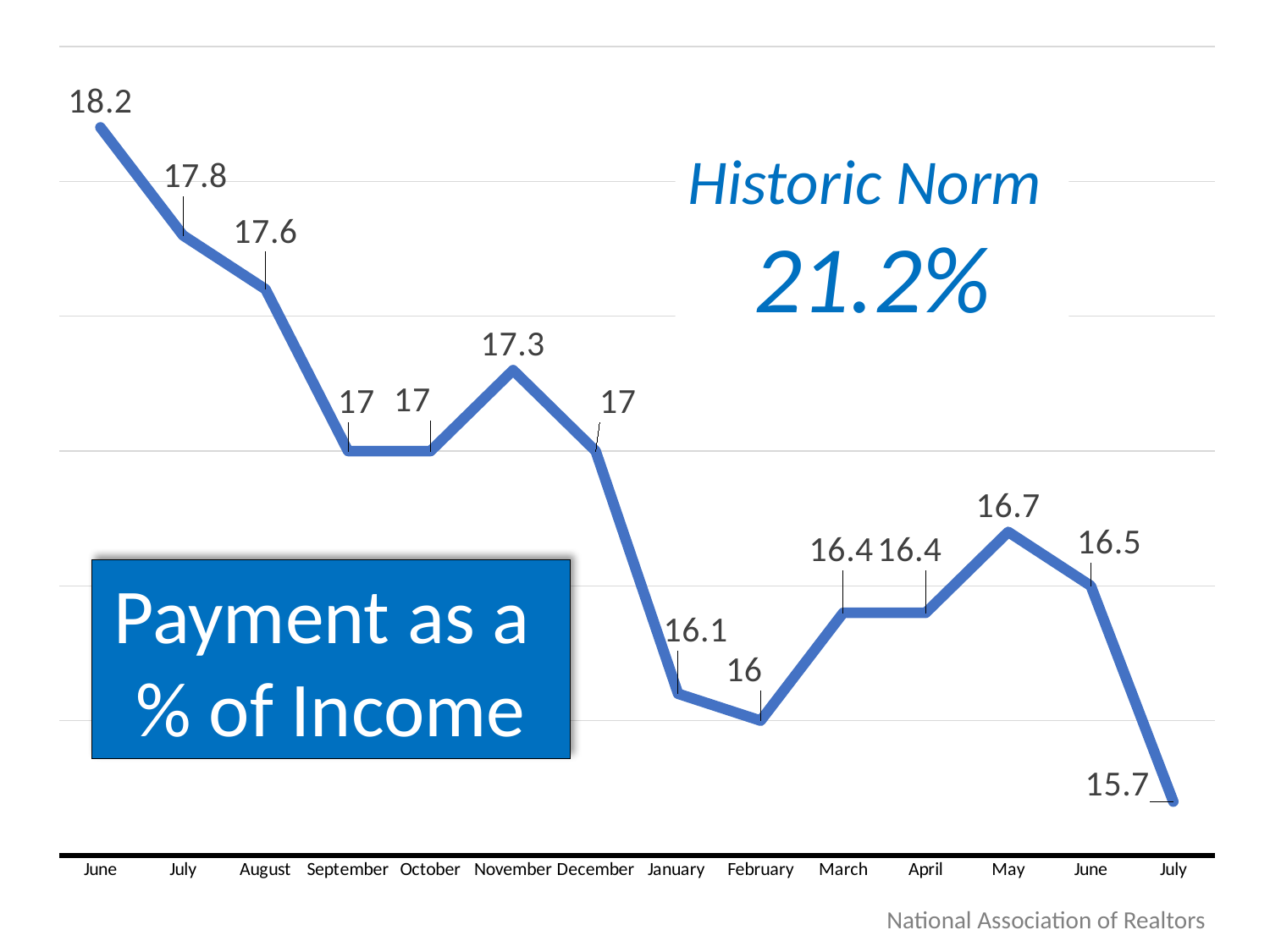
What is the value for November? 17.3 What type of chart is shown on the slide? line chart Overall, do the values rise or fall from the first June to the last July? fall Which month has the lowest value on the chart? July (the last point) What is the value for February? 16 Which month has the highest value on the chart? June (the first point) Which is larger, the value for August or the value for January? August What is the value for May? 16.7 What is the difference between the first June value (18.2) and the last July value (15.7)? 2.5 What historic norm value is printed on the slide? 21.2% What is the value for the first June on the x axis? 18.2 How many data points are plotted on the line? 14